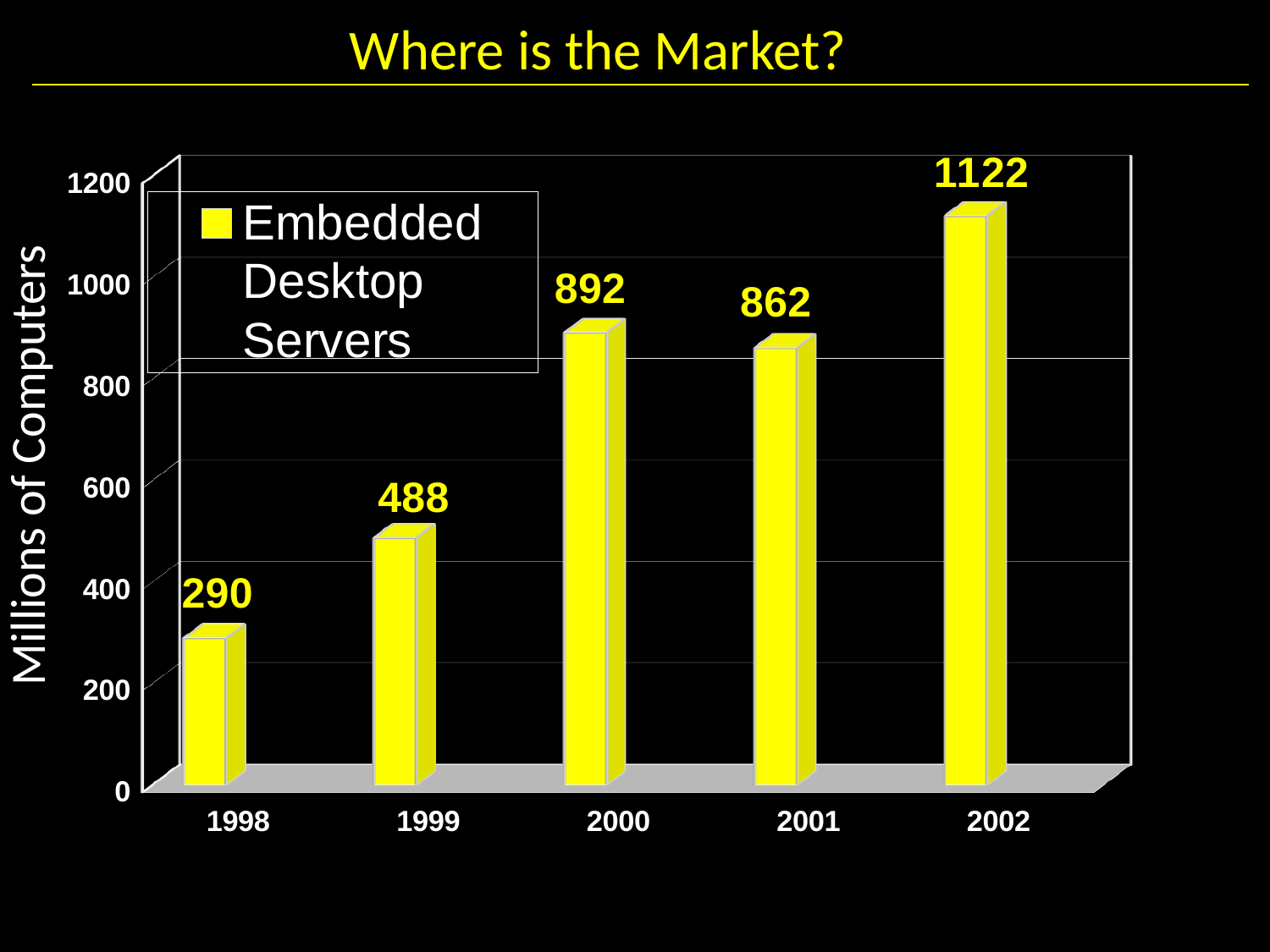
Which year has the highest value? 2002 How many entries does the legend list? 3 What is the y-axis label of the chart? Millions of Computers Which is larger, the value for 2000 or the value for 2001? 2000 What kind of chart is shown on the slide? bar chart What is the value for 2000? 892 What is the value for 1998? 290 Which year has the lowest value? 1998 What is the value for 2002? 1122 What is the difference between the values for 2002 and 2001? 260 What is the difference between the values for 1999 and 1998? 198 How many years are shown on the x axis? 5